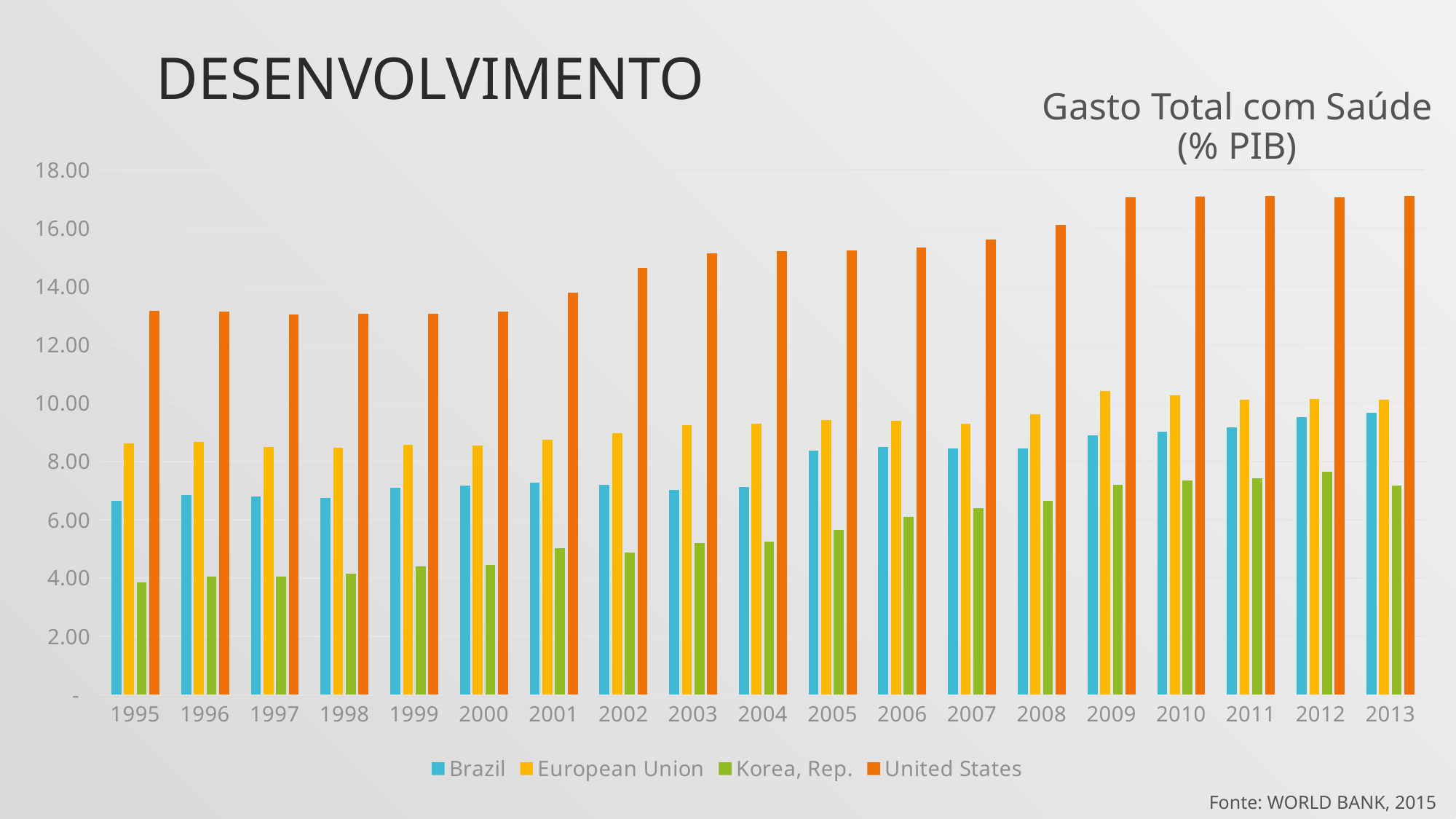
Is the value for Brazil in 2013 greater or less than 8.00? greater What is the title of the chart? Gasto Total com Saúde (% PIB) Which series has the highest value in 2013? United States In 2010, which is larger: Brazil or European Union? European Union What kind of chart is shown on the slide? bar chart How many years are shown on the x axis? 19 Is the value for United States in 2013 greater or less than 16.00? greater In 2013, which is larger: Brazil or Korea, Rep.? Brazil How many series does the legend list? 4 Which series has the lowest value in 1995? Korea, Rep. Is the value for Korea, Rep. in 2000 greater or less than 6.00? less Do the values for United States rise or fall from 1995 to 2013? rise